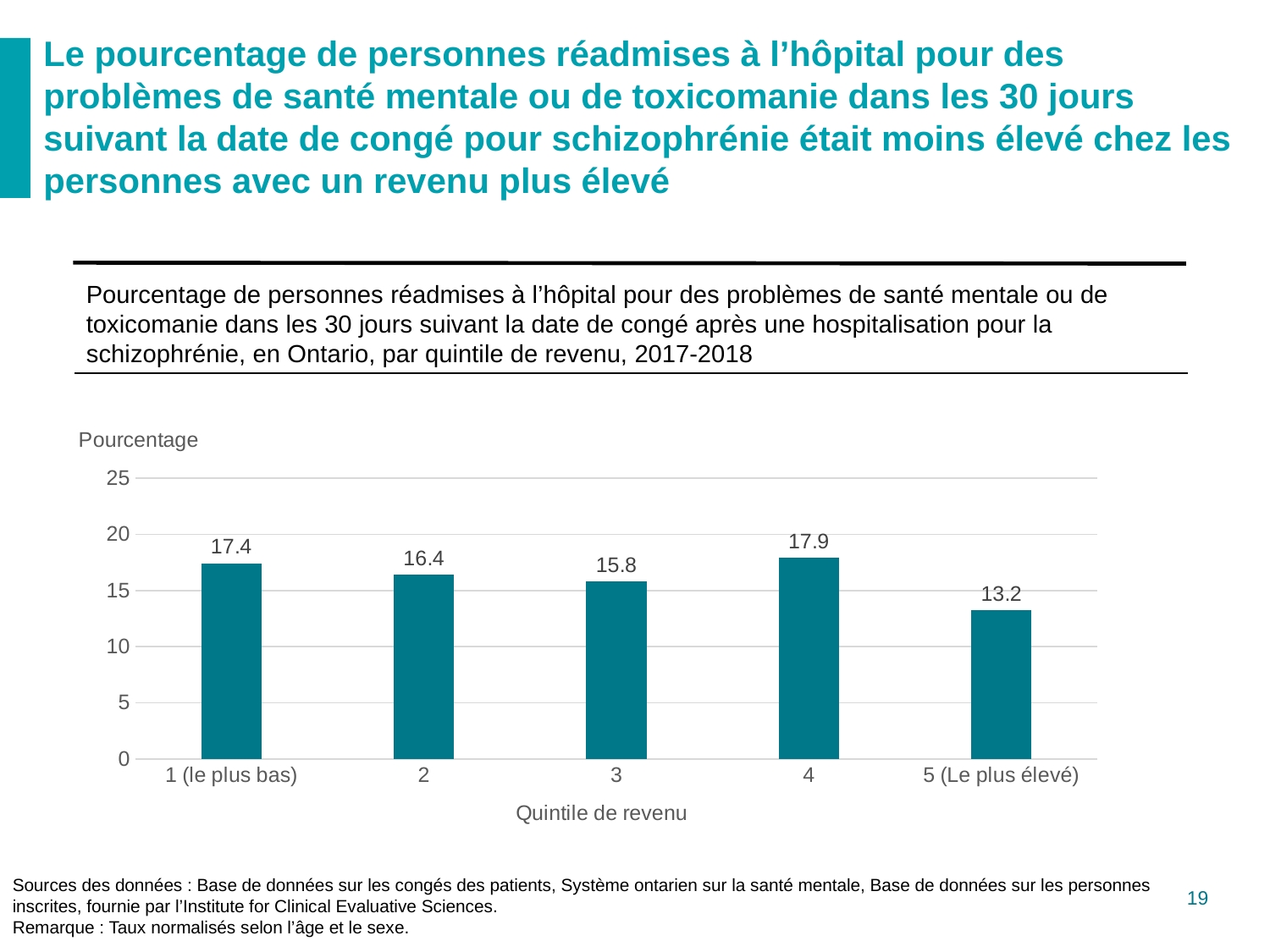
What is the difference between the values for quintile 4 and quintile 5 (Le plus élevé)? 4.7 Which income quintile has the lowest percentage? 5 (Le plus élevé) What is the value for income quintile 1 (le plus bas)? 17.4 Which income quintile has the highest percentage? 4 What is the label of the x axis? Quintile de revenu What is the value for income quintile 3? 15.8 What kind of chart is shown on the slide? Bar chart What is the value for income quintile 5 (Le plus élevé)? 13.2 How many income quintiles are shown on the x axis? 5 Is the value for quintile 4 greater or less than 15? greater Which is larger, the value for quintile 2 or the value for quintile 3? 2 What is the difference between the values for quintile 1 (le plus bas) and quintile 2? 1.0